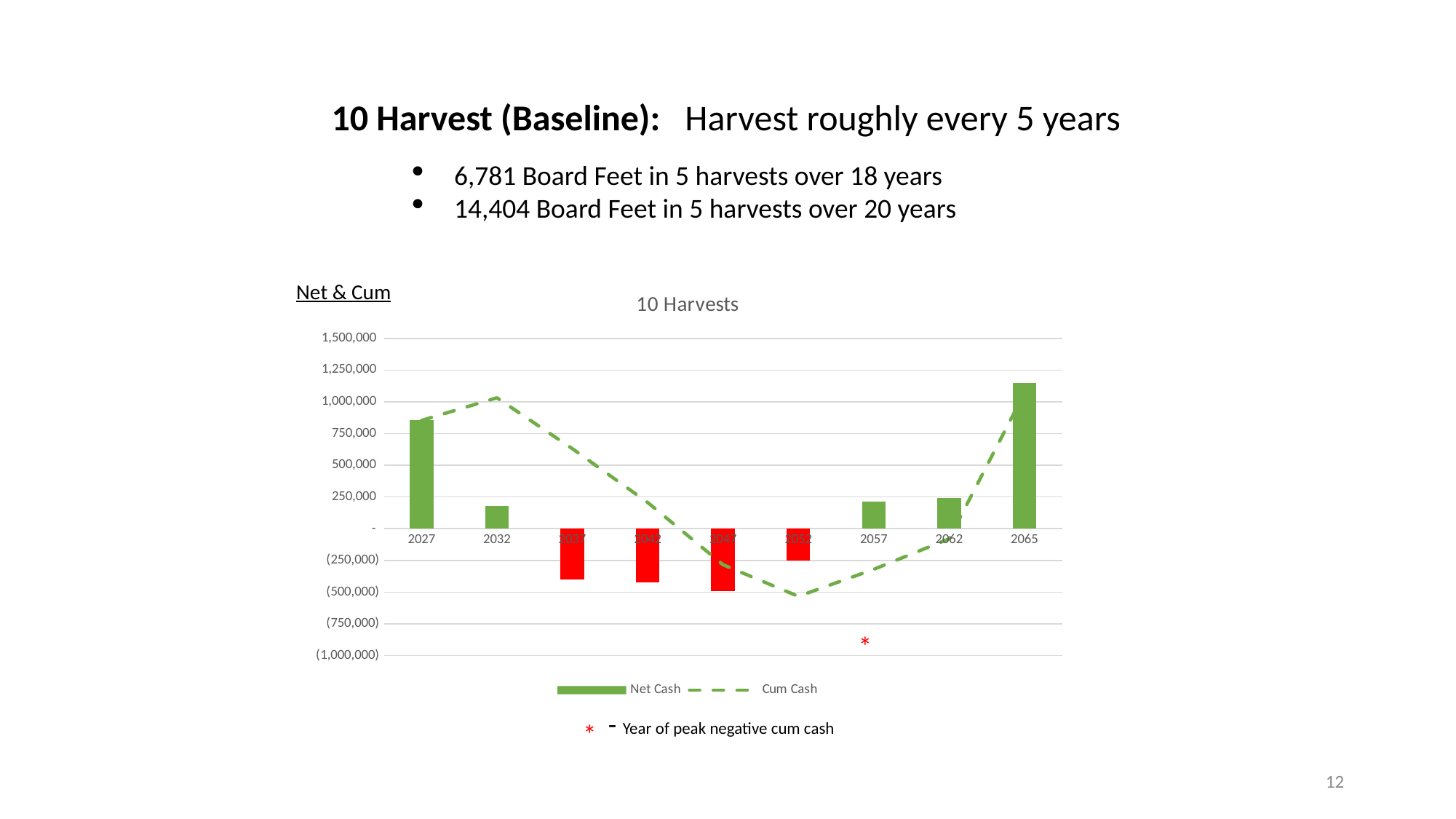
Which year has the lowest (most negative) Net Cash bar? 2047 What kind of chart is used to show Net Cash? Bar chart Is the Net Cash value for 2065 greater or less than 1,000,000? greater What is the title of the chart? 10 Harvests Is the Net Cash value for 2027 greater or less than 750,000? greater How many series does the chart legend list? 2 How many years are shown on the x axis of the chart? 9 Which year has the larger Net Cash bar, 2027 or 2065? 2065 Is the Net Cash value for 2032 greater or less than 250,000? less Which year has the highest Net Cash bar? 2065 What are the two series named in the legend? Net Cash and Cum Cash How many years show a negative (red) Net Cash bar? 4